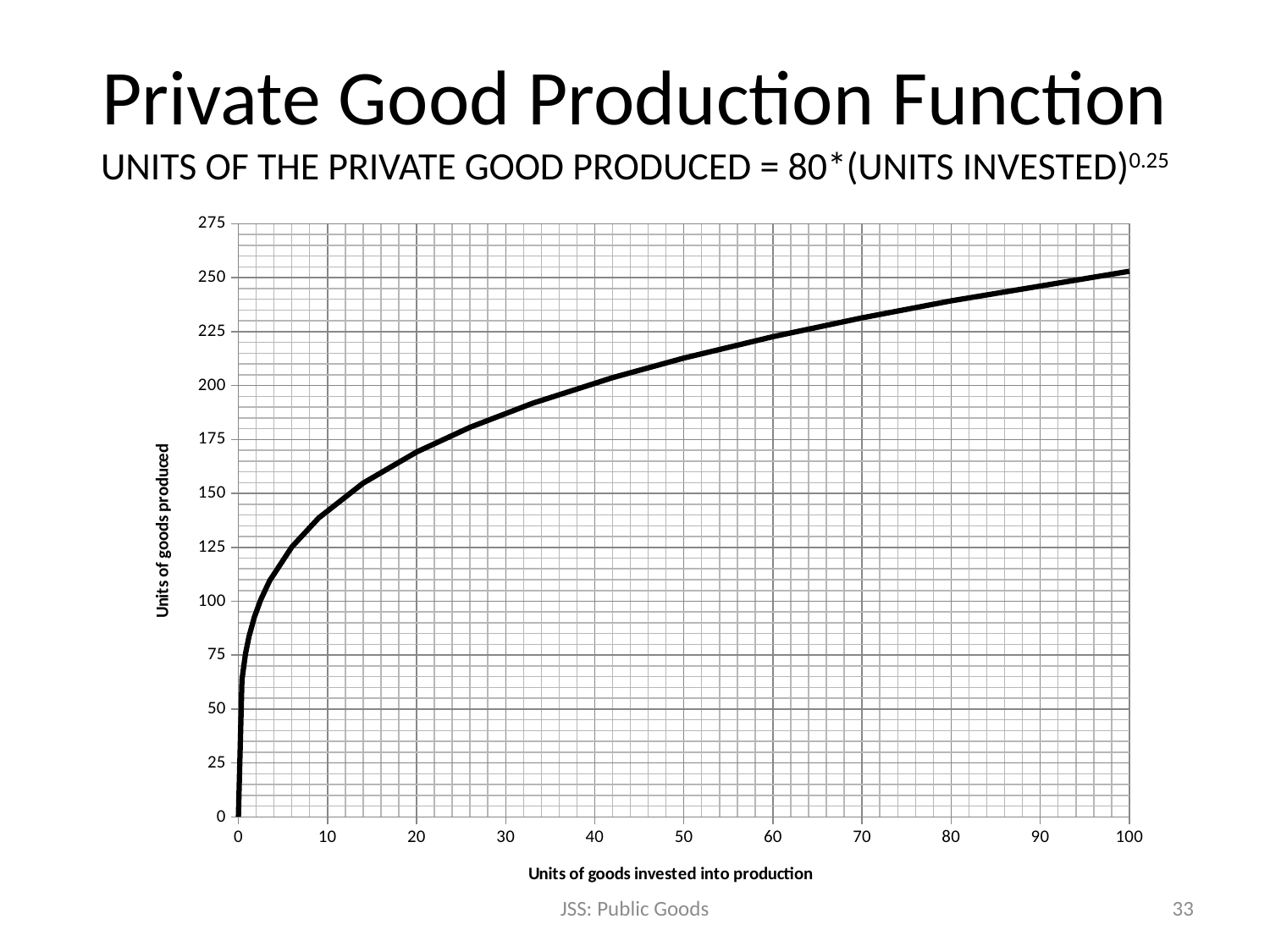
At which number of units invested is the number of units produced highest? 100 Is the value for 100 units invested greater or less than 225? greater What is the title of the chart on the slide? Private Good Production Function Which is larger, the units produced at 20 units invested or at 60 units invested? 60 units invested Is the value for 20 units invested greater or less than 150? greater Is the value for 30 units invested greater or less than 175? greater Do the units of goods produced rise or fall as units invested increase along the x axis? rise What kind of chart is shown on the slide? line chart What is the label of the x axis? Units of goods invested into production